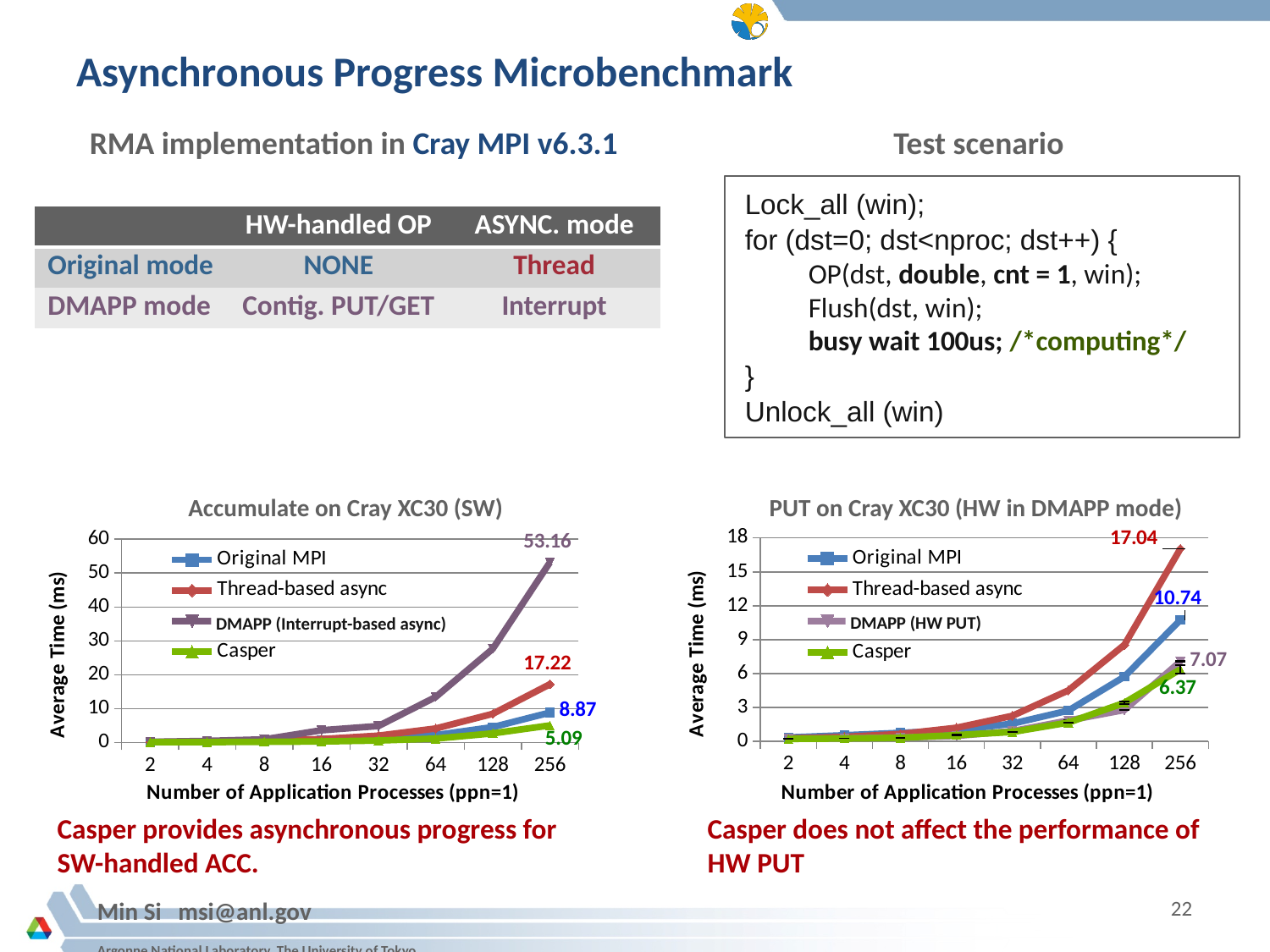
What kind of chart is 'PUT on Cray XC30 (HW in DMAPP mode)'? line chart In the 'PUT on Cray XC30 (HW in DMAPP mode)' chart, what is the average time for Thread-based async at 256 processes? 17.04 In the 'Accumulate on Cray XC30 (SW)' chart, what is the difference between the Thread-based async and Original MPI values at 256 processes? 8.35 In the 'Accumulate on Cray XC30 (SW)' chart, how many process counts are shown on the x axis? 8 In the 'Accumulate on Cray XC30 (SW)' chart, what is the average time for DMAPP (Interrupt-based async) at 256 processes? 53.16 In the 'Accumulate on Cray XC30 (SW)' chart, what is the average time for Casper at 256 processes? 5.09 In the 'PUT on Cray XC30 (HW in DMAPP mode)' chart, is the Original MPI value at 128 processes greater or less than 9? less In the 'PUT on Cray XC30 (HW in DMAPP mode)' chart, what is the average time for Original MPI at 256 processes? 10.74 In the 'Accumulate on Cray XC30 (SW)' chart, which series has the highest value at 256 processes? DMAPP (Interrupt-based async) In the 'Accumulate on Cray XC30 (SW)' chart, how many series does the legend list? 4 In the 'PUT on Cray XC30 (HW in DMAPP mode)' chart, what is the difference between the DMAPP (HW PUT) and Casper values at 256 processes? 0.70 In the 'PUT on Cray XC30 (HW in DMAPP mode)' chart, which series has the lowest value at 256 processes? Casper